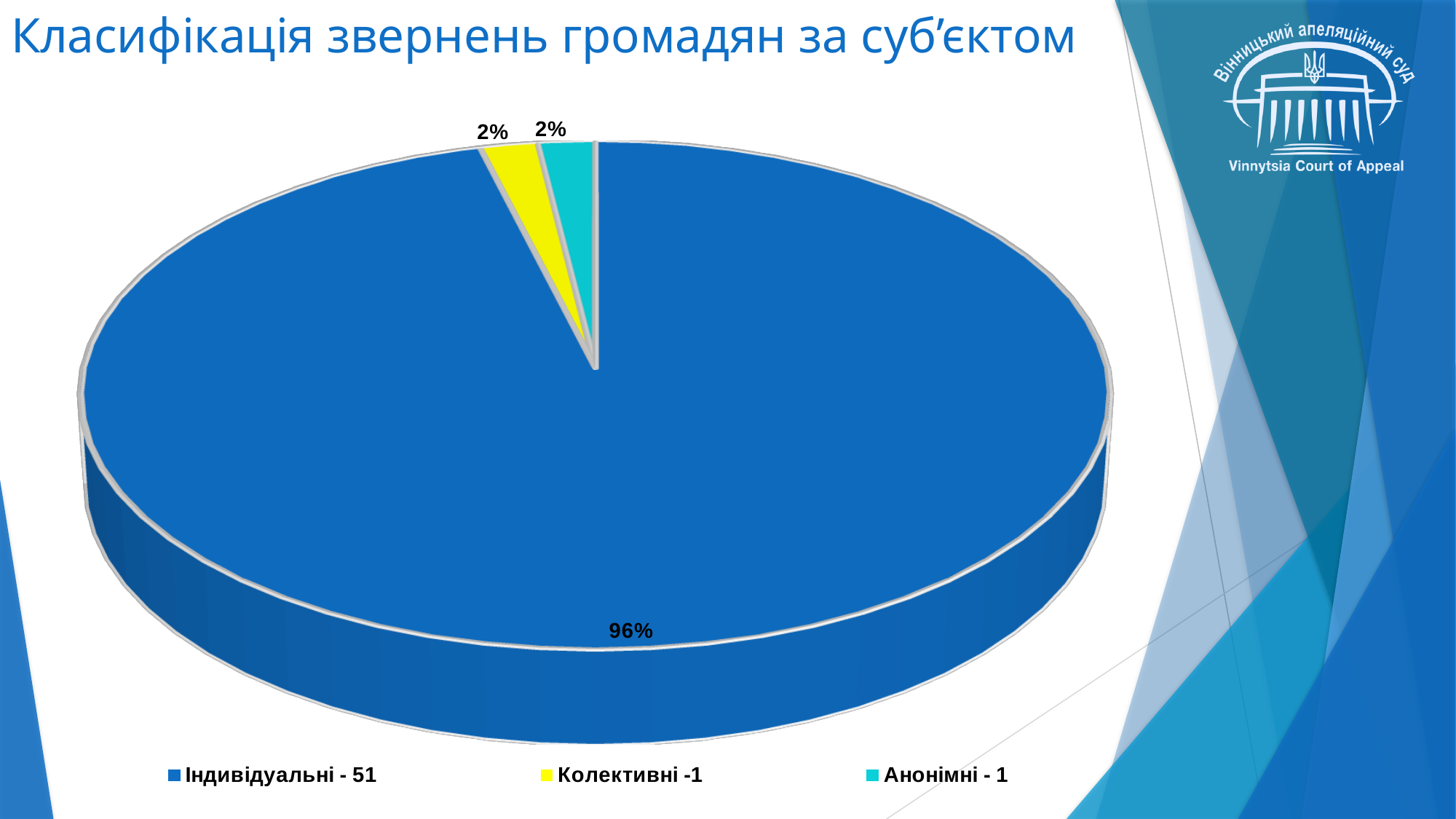
Which category has the largest slice of the pie? Індивідуальні How many slices does the pie chart have? 3 According to the legend, how many appeals are Анонімні? 1 What share of the pie does the Анонімні slice represent? 2% According to the legend, how many appeals are Індивідуальні? 51 What share of the pie does the Індивідуальні slice represent? 96% What colour is the Колективні slice in the pie chart? yellow Which is larger, the Індивідуальні slice or the Колективні slice? Індивідуальні What is the difference in percentage points between the Індивідуальні share and the Колективні share? 94 What is the title of the slide containing the pie chart? Класифікація звернень громадян за суб'єктом What share of the pie does the Колективні slice represent? 2% What kind of chart is shown on the slide? pie chart